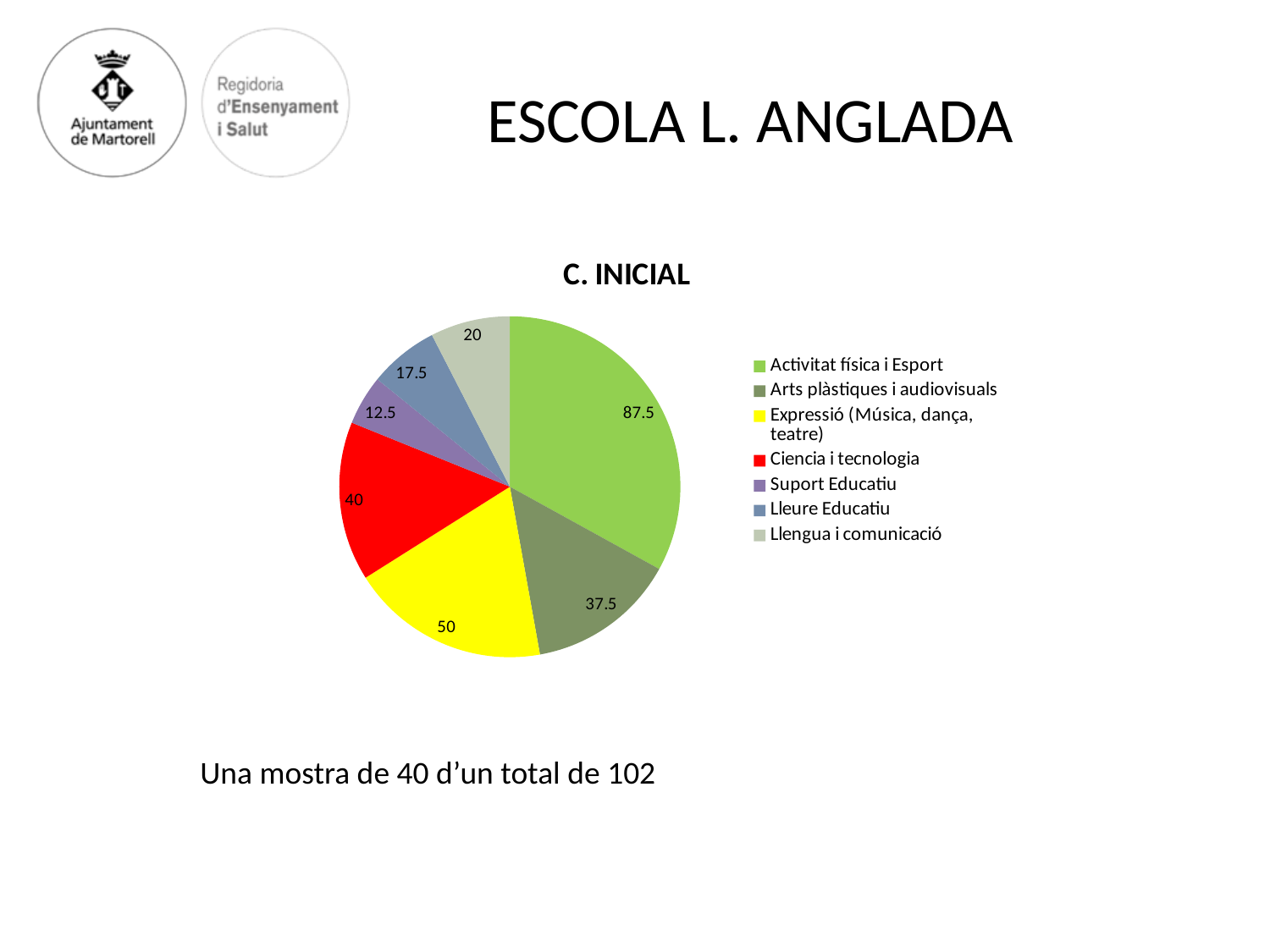
What type of chart is shown on the slide? pie chart What is the difference between the values for Activitat física i Esport and Arts plàstiques i audiovisuals? 50 What is the value for Activitat física i Esport? 87.5 What is the value for Ciencia i tecnologia? 40 What is the title of the chart? C. INICIAL Which category has the largest slice of the pie? Activitat física i Esport How many categories does the legend list? 7 What is the value for Expressió (Música, dança, teatre)? 50 Which is larger, the value for Expressió (Música, dança, teatre) or the value for Ciencia i tecnologia? Expressió (Música, dança, teatre) What is the difference between the values for Llengua i comunicació and Lleure Educatiu? 2.5 What is the value for Suport Educatiu? 12.5 Which category has the smallest slice of the pie? Suport Educatiu